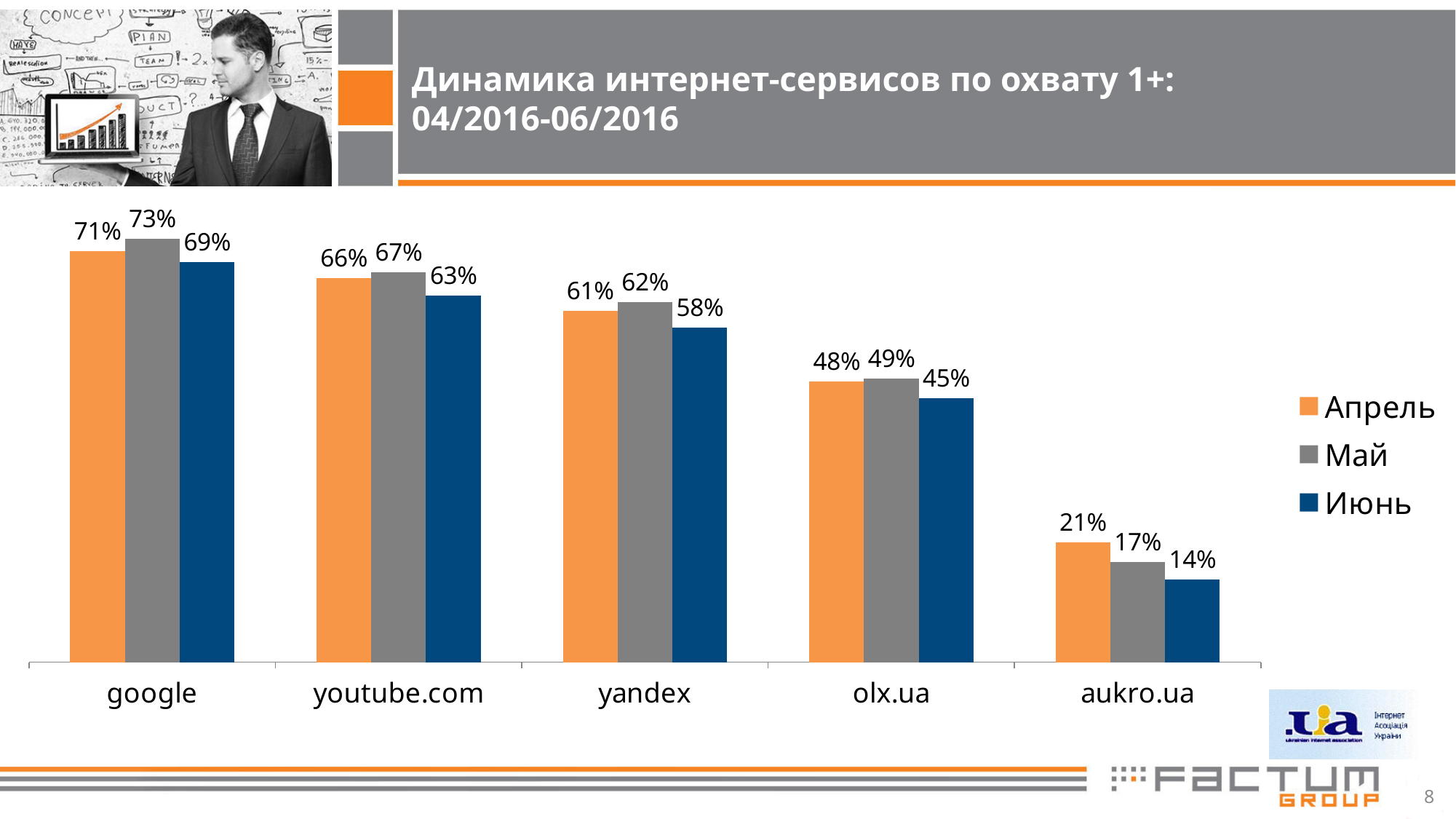
What is the value for yandex in Апрель (April)? 61% Do the Июнь (June) values rise or fall from google to aukro.ua along the x axis? Fall How many categories are shown on the x axis? 5 Which category has the highest value in Июнь (June)? google What is the difference between the Май (May) and Июнь (June) values for olx.ua? 4% Which colour represents Май (May) in the legend? Grey Which category has the lowest value in Апрель (April)? aukro.ua What kind of chart is shown on the slide? Bar chart What is the value for google in Май (May)? 73% What is the value for aukro.ua in Июнь (June)? 14% Which is larger for youtube.com: the Апрель (April) value or the Июнь (June) value? Апрель (April) How many series does the legend list? 3